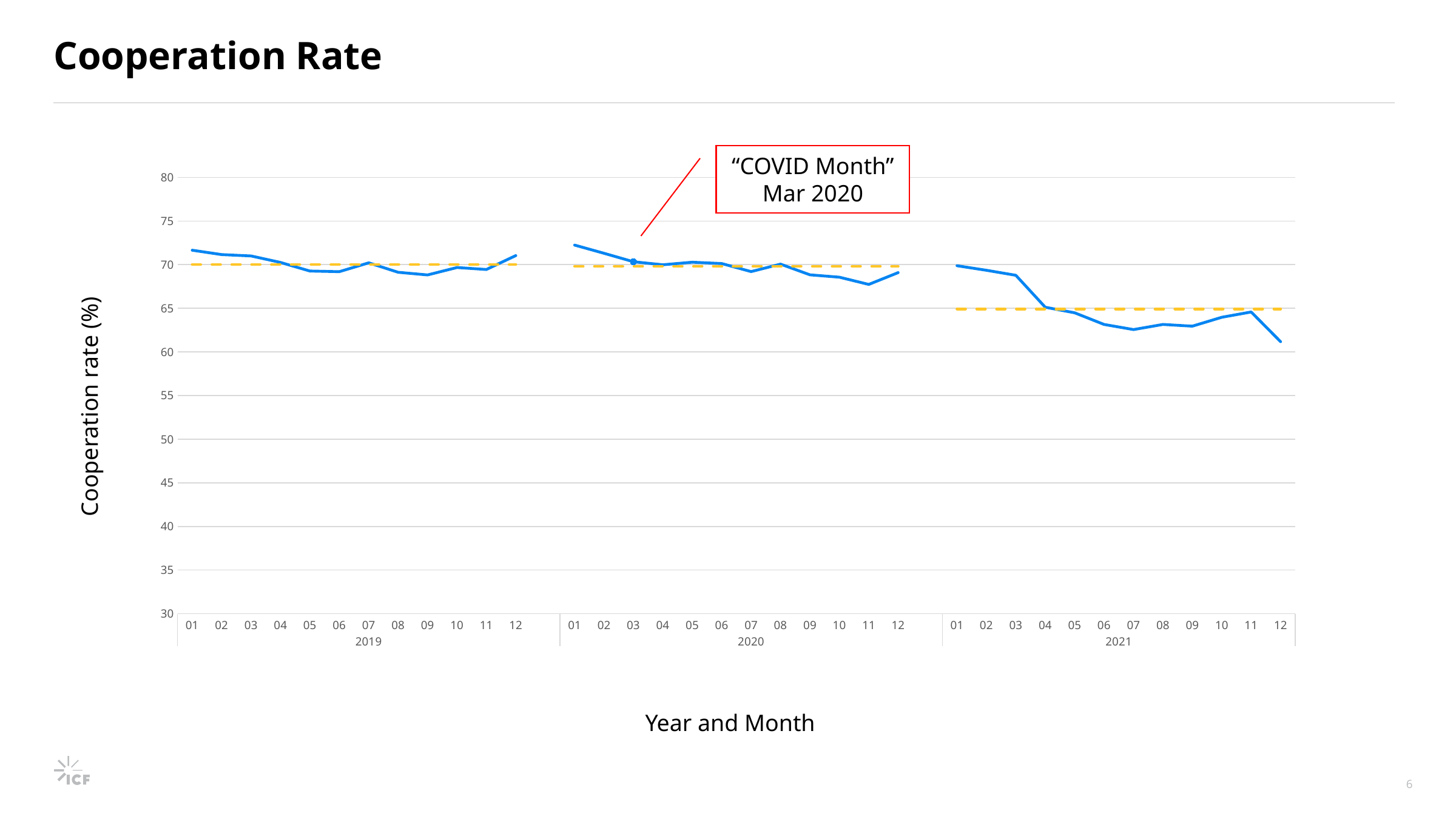
How many monthly points are plotted for the year 2021? 12 Which month has the lowest cooperation rate in the chart? 12 (December) 2021 Is the cooperation rate for month 12 of 2021 greater or less than 65? less Is the cooperation rate for month 01 of 2019 greater or less than 70? greater Which is larger, the cooperation rate for month 01 of 2019 or for month 12 of 2021? month 01 of 2019 What kind of chart is shown on the slide? line chart Is the cooperation rate for month 07 of 2021 greater or less than 65? less How many years are shown along the x axis of the chart? 3 What is the title of the chart on the slide? Cooperation Rate Does the cooperation rate generally rise or fall across the months of 2021? fall Which month is labelled as the "COVID Month" in the chart annotation? Mar 2020